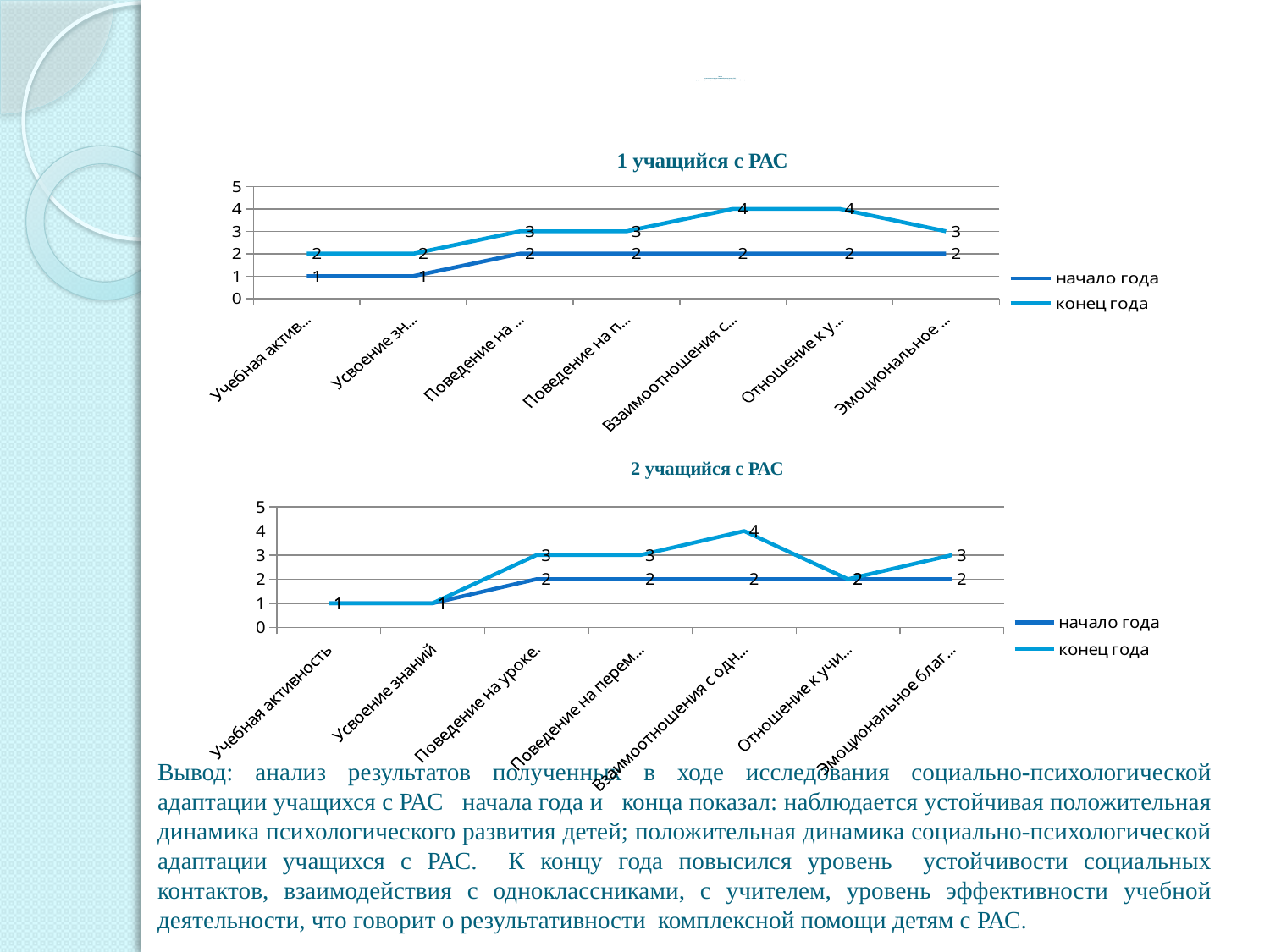
What are the two legend entries in "1 учащийся с РАС"? начало года, конец года In "1 учащийся с РАС", which series is higher for the fifth category ("Взаимоотношения с...")? конец года In "1 учащийся с РАС", what is the difference between "конец года" and "начало года" for the first category ("Учебная актив...")? 1 In "2 учащийся с РАС", what is the value of "начало года" for "Учебная активность"? 1 In "1 учащийся с РАС", what is the highest value reached by the "конец года" series? 4 In "2 учащийся с РАС", which series has the larger value for "Усвоение знаний", or are they equal? equal How many series does the legend of "2 учащийся с РАС" list? 2 How many categories are plotted on the x axis of "2 учащийся с РАС"? 7 In "2 учащийся с РАС", what is the highest value reached by the "конец года" series? 4 In "1 учащийся с РАС", does the "начало года" series rise or fall from the first category to the third? rise What kind of chart is "1 учащийся с РАС"? line chart In "2 учащийся с РАС", what is the value of "конец года" for "Поведение на уроке."? 3